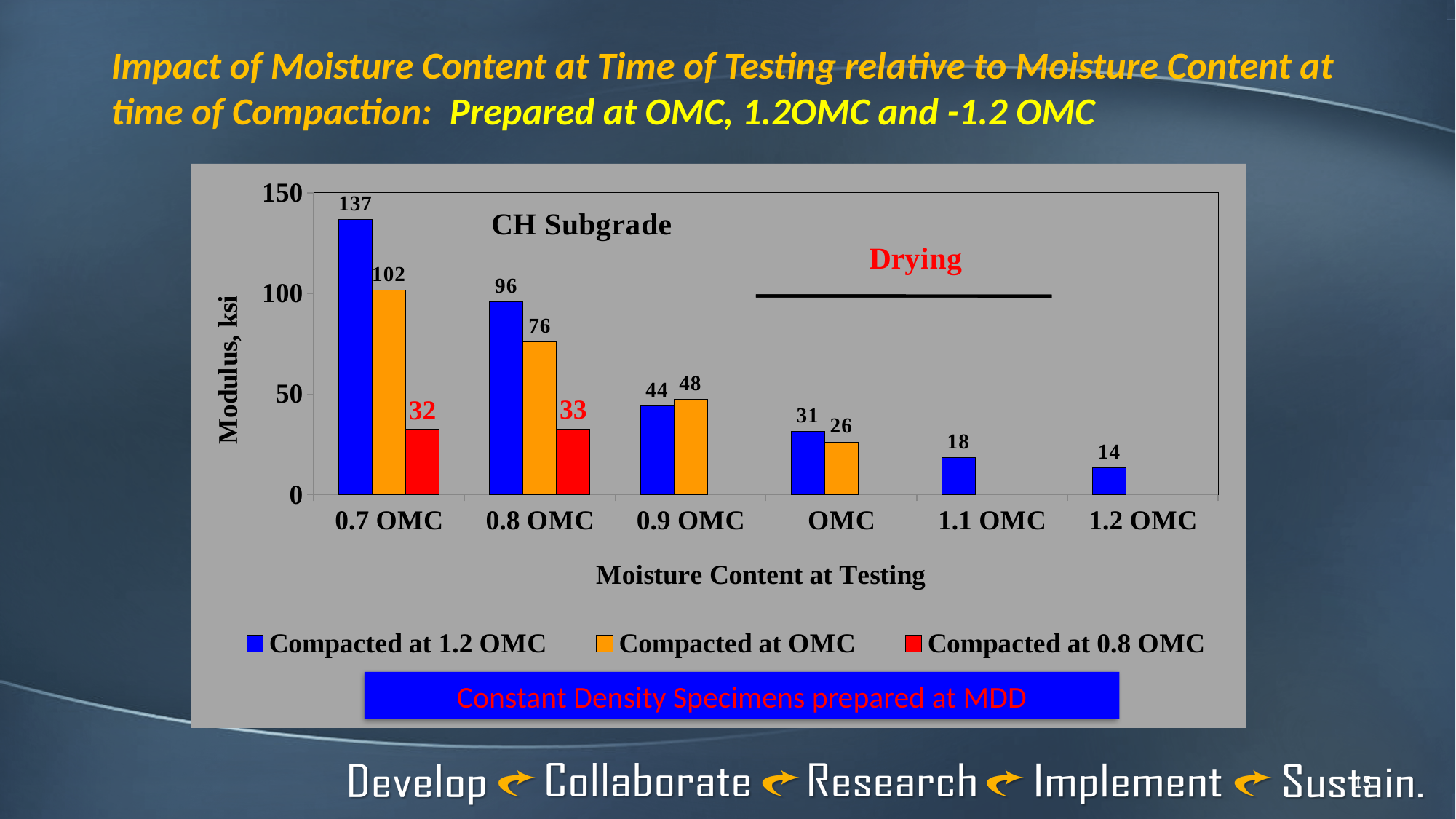
What kind of chart is shown on the slide? Bar chart How many moisture content categories are shown on the x axis? 6 What is the difference between the Compacted at 1.2 OMC and Compacted at OMC values at 0.7 OMC moisture content at testing? 35 Does the modulus for Compacted at 1.2 OMC rise or fall as moisture content at testing increases from 0.7 OMC to 1.2 OMC? Fall Which moisture content at testing has the lowest modulus for the Compacted at OMC series? OMC What is the modulus for Compacted at OMC at 0.8 OMC moisture content at testing? 76 What is the modulus for Compacted at 1.2 OMC at 1.2 OMC moisture content at testing? 14 At 0.9 OMC moisture content at testing, which is larger: Compacted at 1.2 OMC or Compacted at OMC? Compacted at OMC What is the modulus for Compacted at 0.8 OMC at 0.8 OMC moisture content at testing? 33 What is the modulus for Compacted at 1.2 OMC at 0.7 OMC moisture content at testing? 137 How many series does the legend list? 3 Which moisture content at testing has the highest modulus for the Compacted at 1.2 OMC series? 0.7 OMC